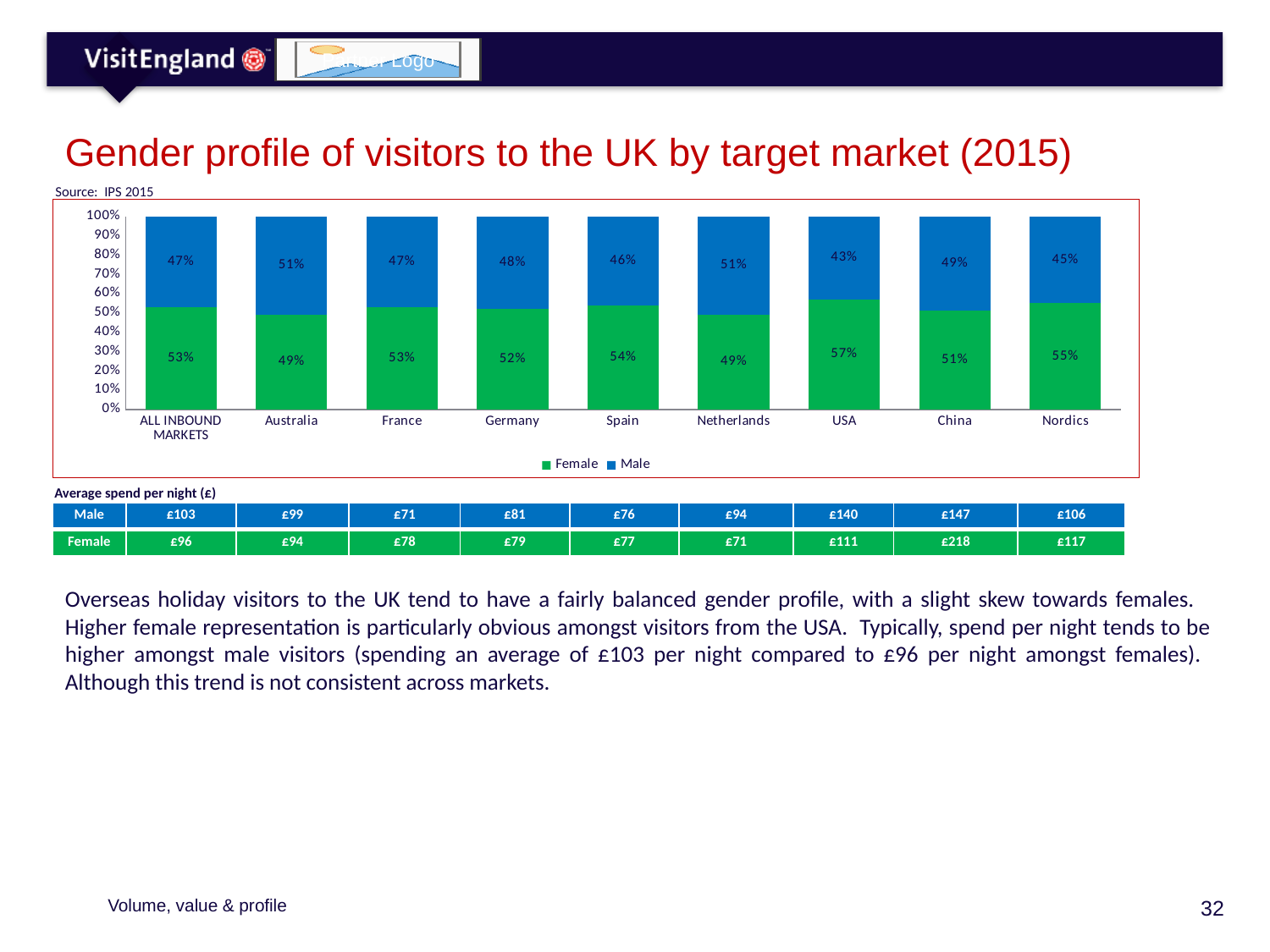
What is the Male share for Germany? 48% What type of chart is used to show the gender profile? Stacked bar chart Which colour represents Female in the chart? Green What is the difference between the Female and Male shares for the USA? 14 percentage points How many series does the chart legend list? 2 What percentage of visitors from the USA are female? 57% Which market has the lowest Male share? USA For Australia, which is larger, the Female share or the Male share? Male Which market has the highest Female share? USA What is the Female share for Spain? 54% What is the Male share for ALL INBOUND MARKETS? 47% How many markets are shown on the x axis of the chart? 9